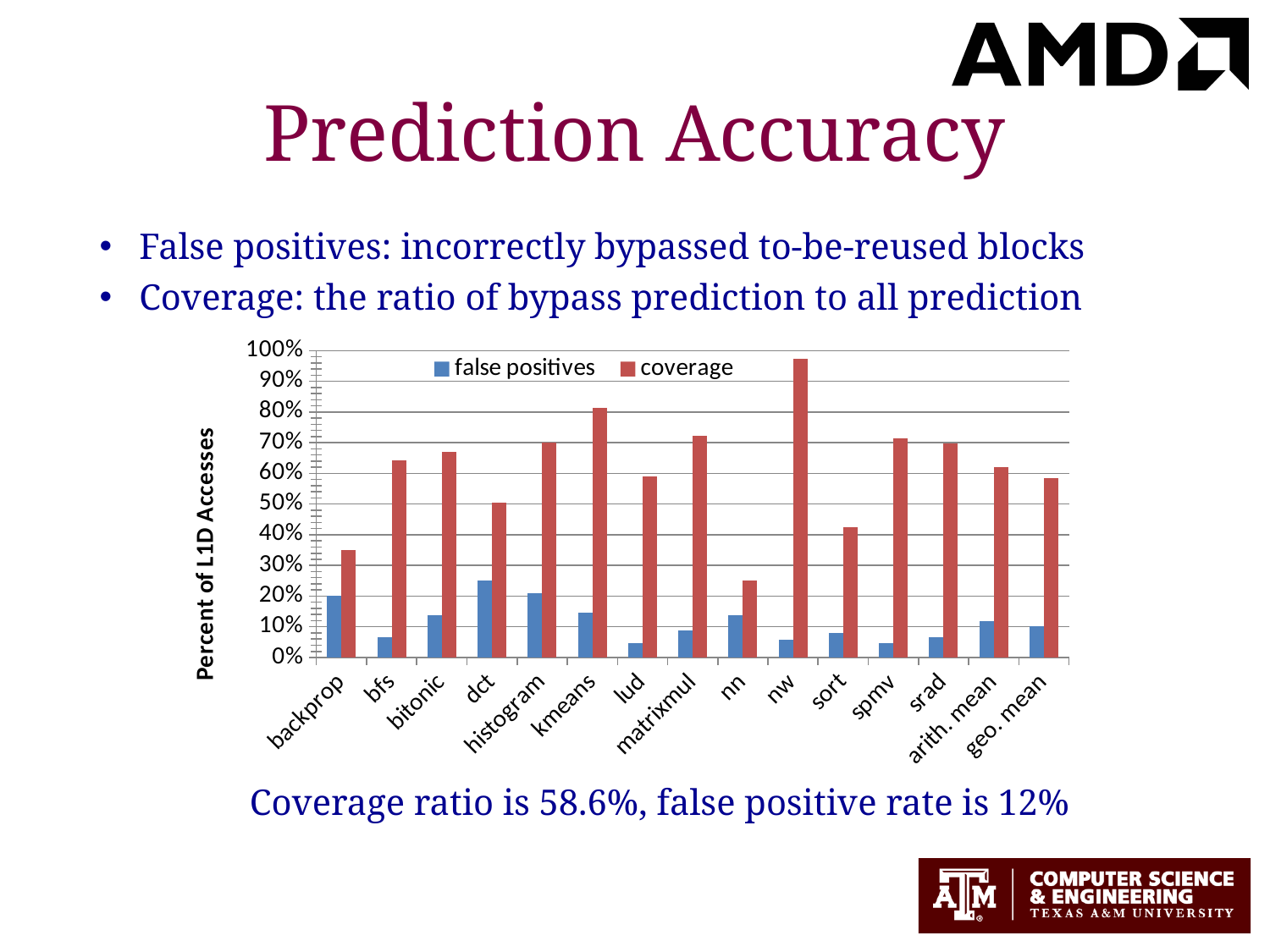
Is the coverage value for nn greater or less than 30%? less Is the coverage value for sort greater or less than 50%? less What kind of chart is shown on the slide? bar chart Which category has the highest false positives value? dct Is the coverage value for nw greater or less than 90%? greater What is the title of the y axis? Percent of L1D Accesses How many categories are shown along the x axis? 15 Which category has the lowest coverage value? nn Which category has the highest coverage value? nw How many series does the legend list? 2 Which has the larger coverage value, kmeans or lud? kmeans